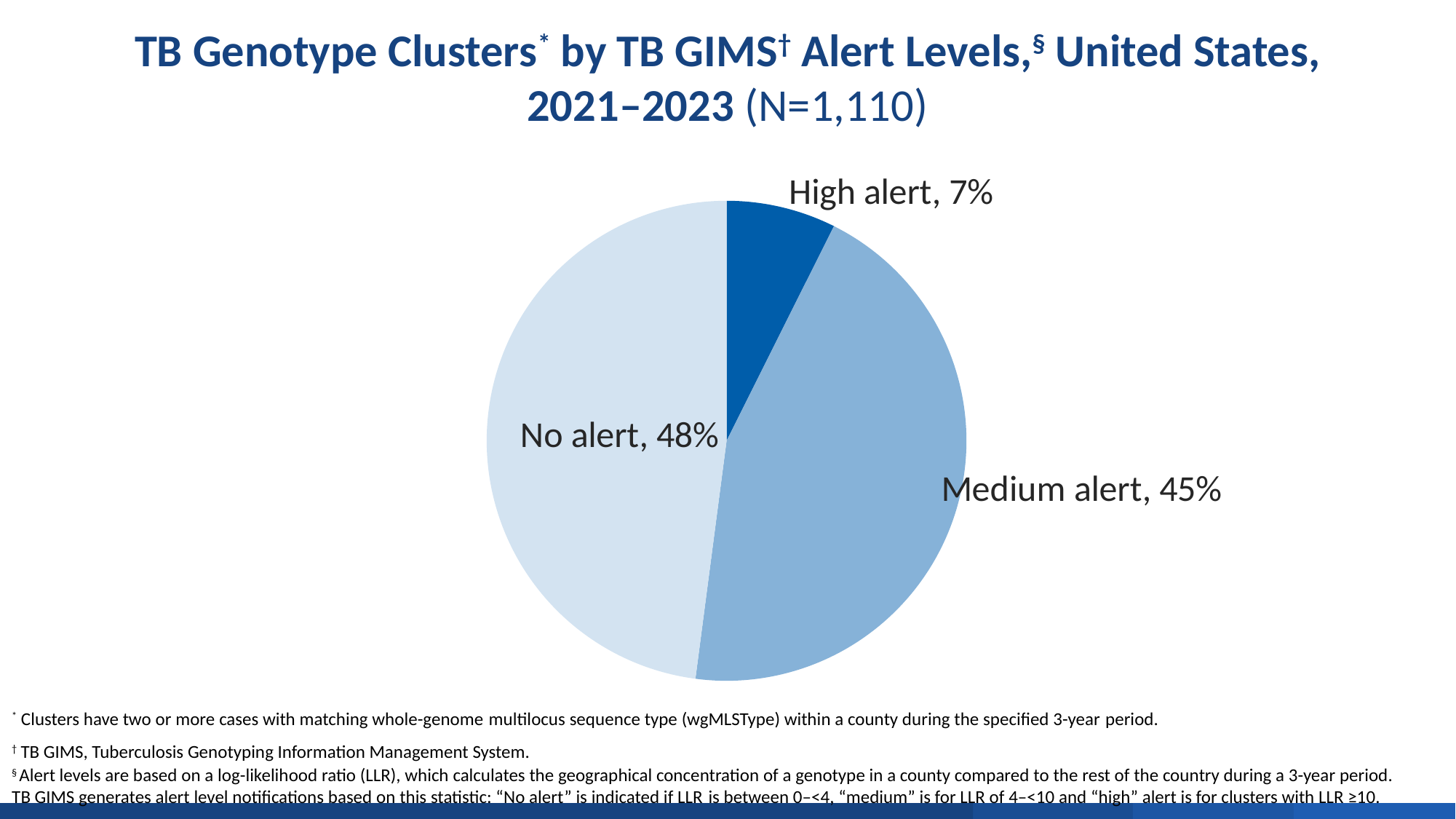
What is the difference in percentage points between the Medium alert and High alert shares? 38 What share of TB genotype clusters is labeled as High alert? 7% What share of TB genotype clusters is labeled as Medium alert? 45% How many slices does the pie chart have? 3 What share of TB genotype clusters is labeled as No alert? 48% What is the total number of clusters (N) given in the chart title? 1,110 Which alert level has the smallest share of the pie? High alert What kind of chart is shown on the slide? pie chart Which is larger, the Medium alert share or the High alert share? Medium alert Which years does the chart title say the data cover? 2021–2023 What is the difference in percentage points between the No alert and Medium alert shares? 3 Which alert level has the largest share of the pie? No alert